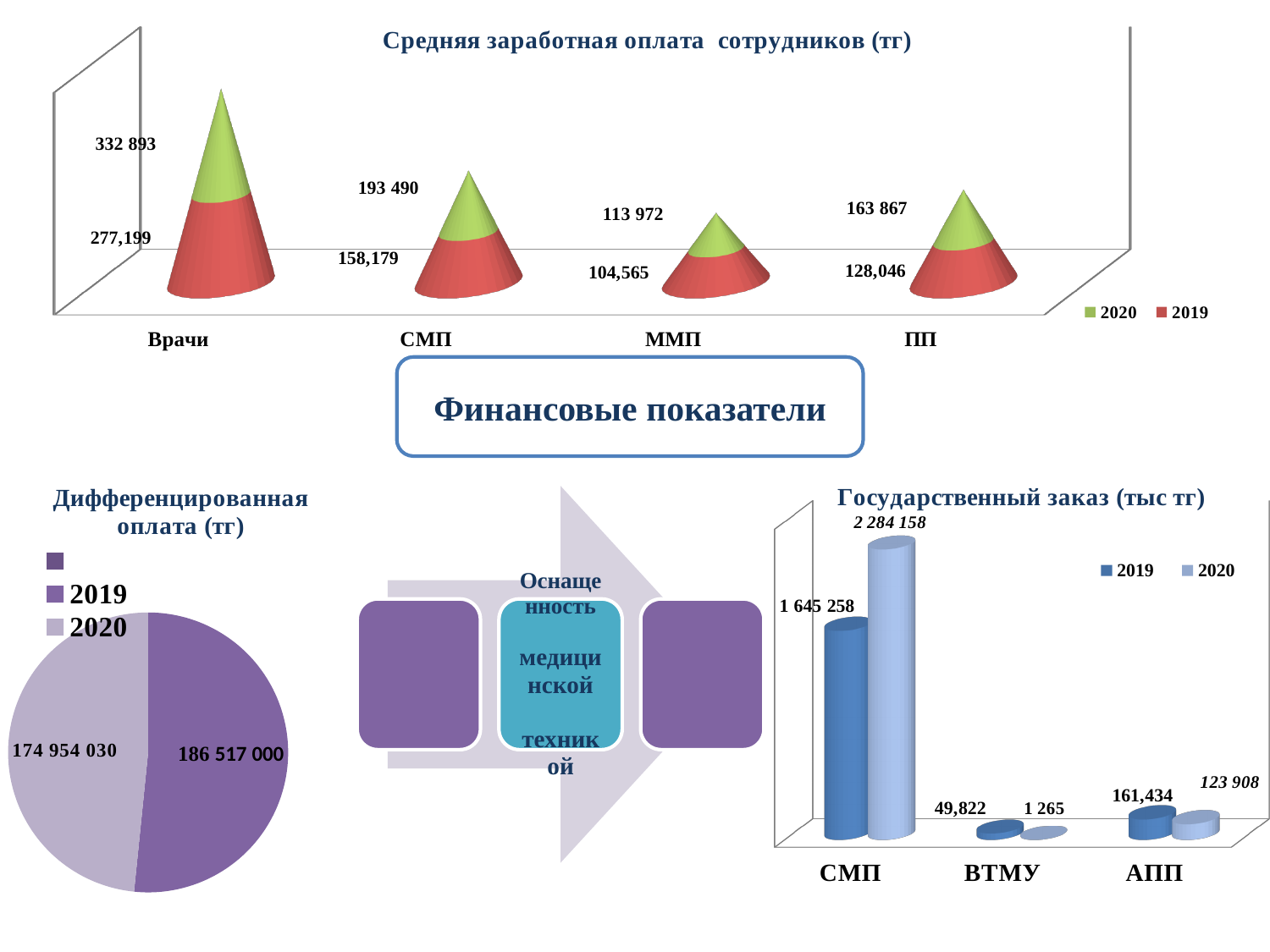
In the chart 'Средняя заработная оплата сотрудников (тг)', which is larger for СМП: the 2020 value or the 2019 value? 2020 How many categories are shown in the chart 'Средняя заработная оплата сотрудников (тг)'? 4 In the chart 'Средняя заработная оплата сотрудников (тг)', what is the 2020 value for Врачи? 332 893 What kind of chart is 'Дифференцированная оплата (тг)'? Pie chart In the chart 'Средняя заработная оплата сотрудников (тг)', what is the difference between the 2020 and 2019 values for Врачи? 55,694 In the chart 'Государственный заказ (тыс тг)', what is the 2019 value for ВТМУ? 49,822 In the chart 'Средняя заработная оплата сотрудников (тг)', which category has the lowest 2020 value? ММП In the chart 'Государственный заказ (тыс тг)', which category has the highest 2019 value? СМП In the chart 'Государственный заказ (тыс тг)', what is the 2020 value for СМП? 2 284 158 In the chart 'Средняя заработная оплата сотрудников (тг)', what is the 2019 value for ПП? 128,046 In the pie chart 'Дифференцированная оплата (тг)', what is the value for 2019? 186 517 000 How many series does the legend list in the chart 'Государственный заказ (тыс тг)'? 2